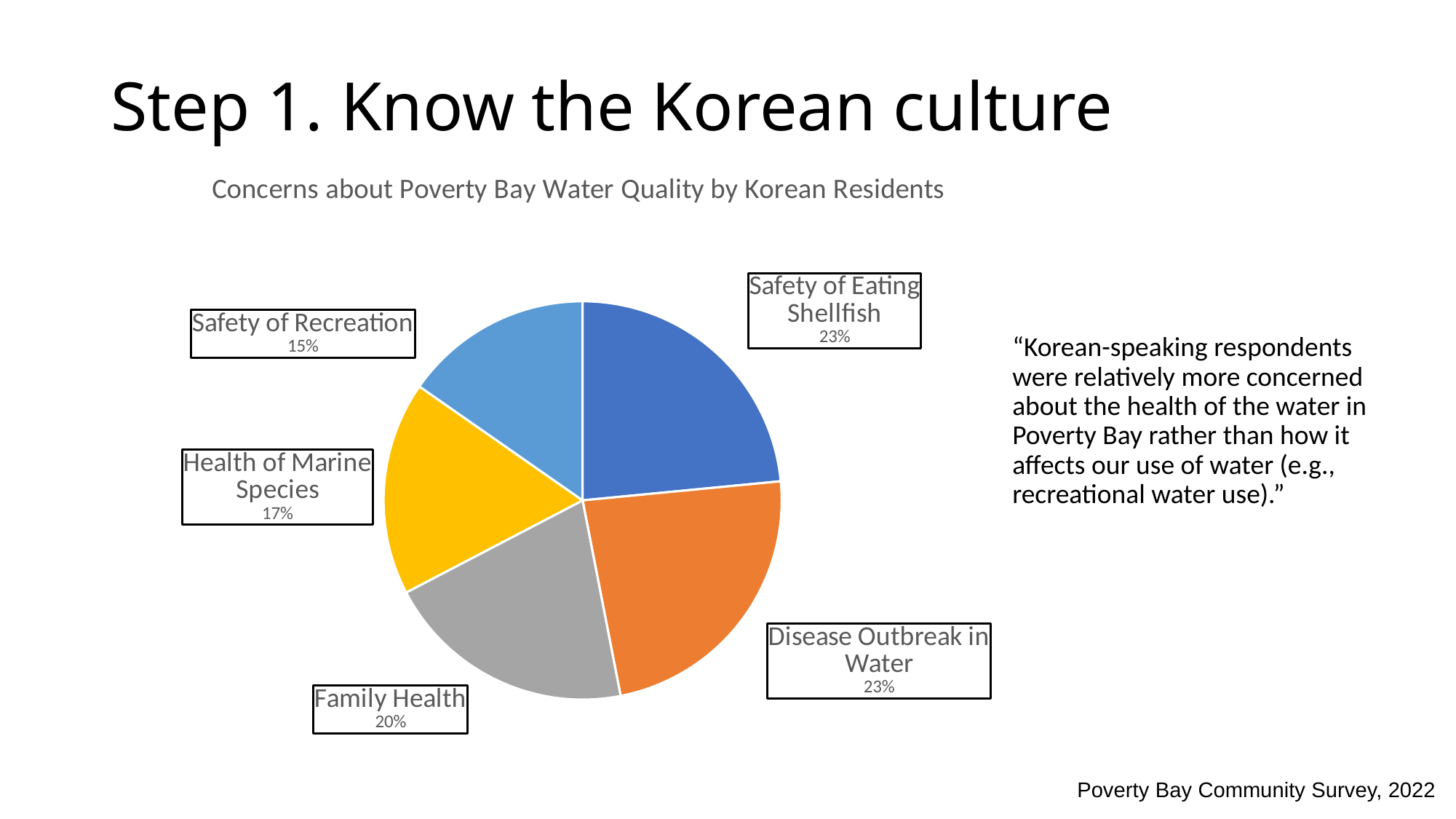
How many categories are shown in the pie chart? 5 What is the title of the chart? Concerns about Poverty Bay Water Quality by Korean Residents Which category has the smallest slice of the pie? Safety of Recreation What is the difference between the shares for Family Health and Safety of Recreation? 5% What share of the pie is Family Health? 20% What kind of chart is shown on the slide? pie chart What colour is the Family Health slice? grey What is the difference between the shares for Disease Outbreak in Water and Health of Marine Species? 6% What share of the pie is Safety of Eating Shellfish? 23% What share of the pie is Health of Marine Species? 17% Which is larger, the share for Family Health or the share for Health of Marine Species? Family Health